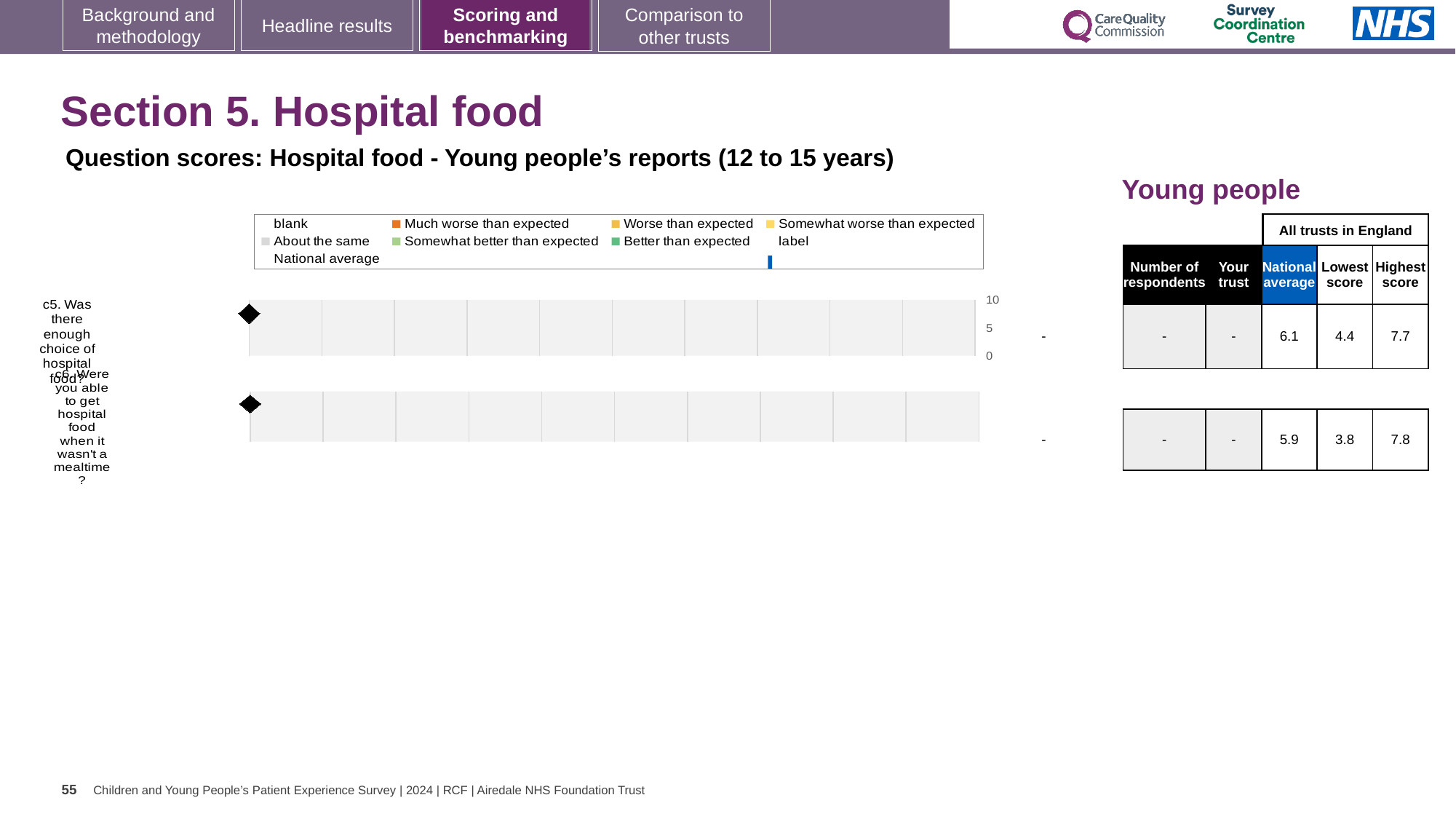
In the table beside the chart, what is the national average score for c5 (Was there enough choice of hospital food?)? 6.1 How many entries does the chart's legend list? 9 What is the highest tick value shown on the chart's axis? 10 In the table beside the chart, what is the highest score for c5? 7.7 In the table beside the chart, what is the lowest score for c6 (Were you able to get hospital food when it wasn't a mealtime?)? 3.8 How many question categories are plotted on the chart? 2 What kind of chart is shown on the slide? bar chart In the table beside the chart, what is the difference between the highest score and the lowest score for c5? 3.3 What is the heading printed above the chart? Question scores: Hospital food - Young people’s reports (12 to 15 years) In the table beside the chart, what is the difference between the highest score and the lowest score for c6? 4.0 In the table beside the chart, which question has the higher national average, c5 or c6? c5 In the table beside the chart, what value is shown for 'Your trust' for c5? -